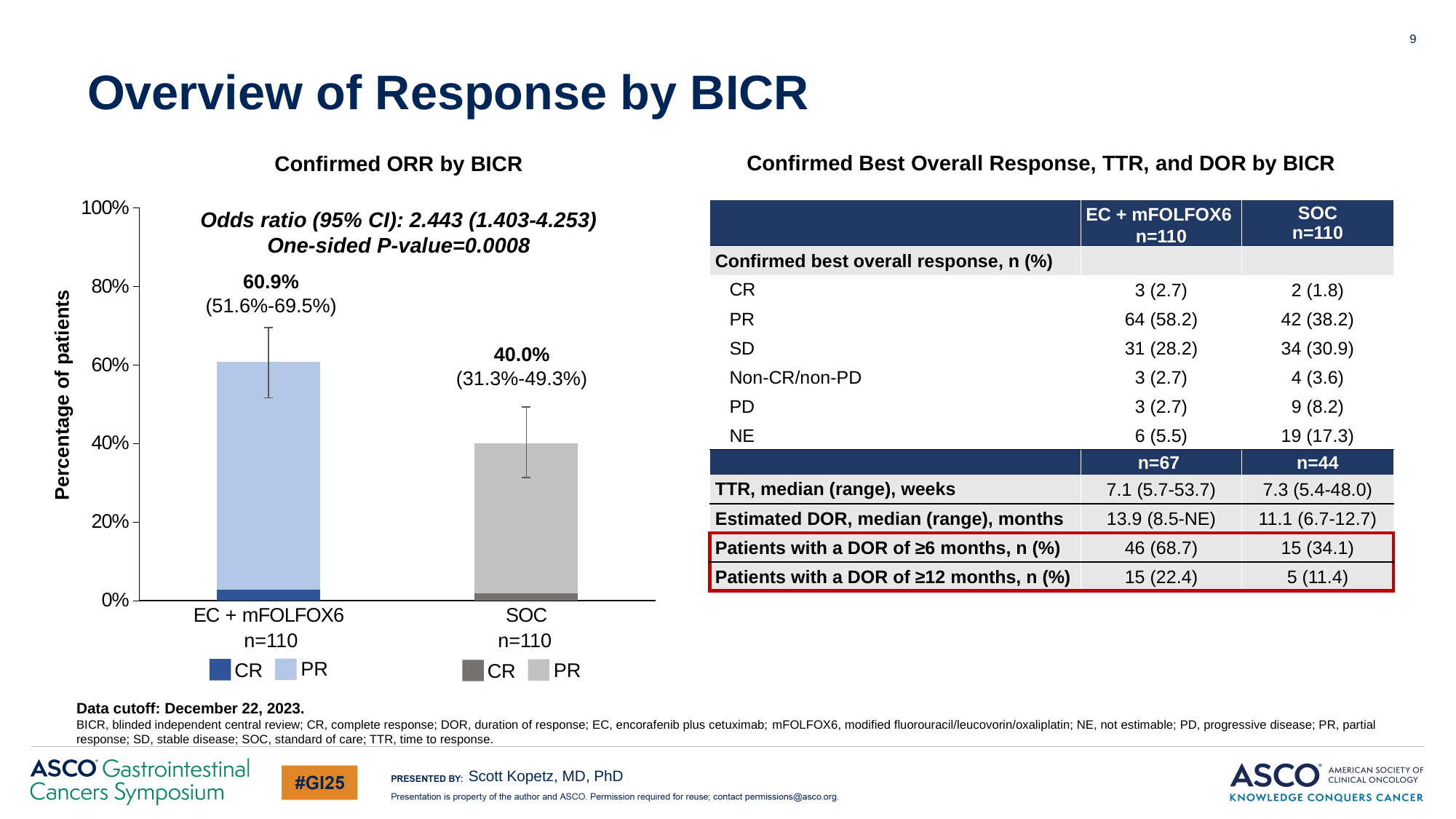
What is the confirmed ORR for EC + mFOLFOX6 in the Confirmed ORR by BICR chart? 60.9% What odds ratio is reported in the Confirmed ORR by BICR chart? 2.443 (1.403-4.253) What is the 95% confidence interval shown above the SOC bar? 31.3%-49.3% Which treatment arm has the higher confirmed ORR in the bar chart? EC + mFOLFOX6 What is the confirmed ORR for SOC in the Confirmed ORR by BICR chart? 40.0% What type of chart is used to show Confirmed ORR by BICR? Stacked bar chart What is the 95% confidence interval shown above the EC + mFOLFOX6 bar? 51.6%-69.5% Is the confirmed ORR for SOC greater or less than 50%? less What is the difference in confirmed ORR between EC + mFOLFOX6 and SOC in the bar chart? 20.9 percentage points How many response categories does the legend of the bar chart list for each arm? 2 How many treatment arms are plotted in the Confirmed ORR by BICR chart? 2 What is the label on the y-axis of the Confirmed ORR by BICR chart? Percentage of patients